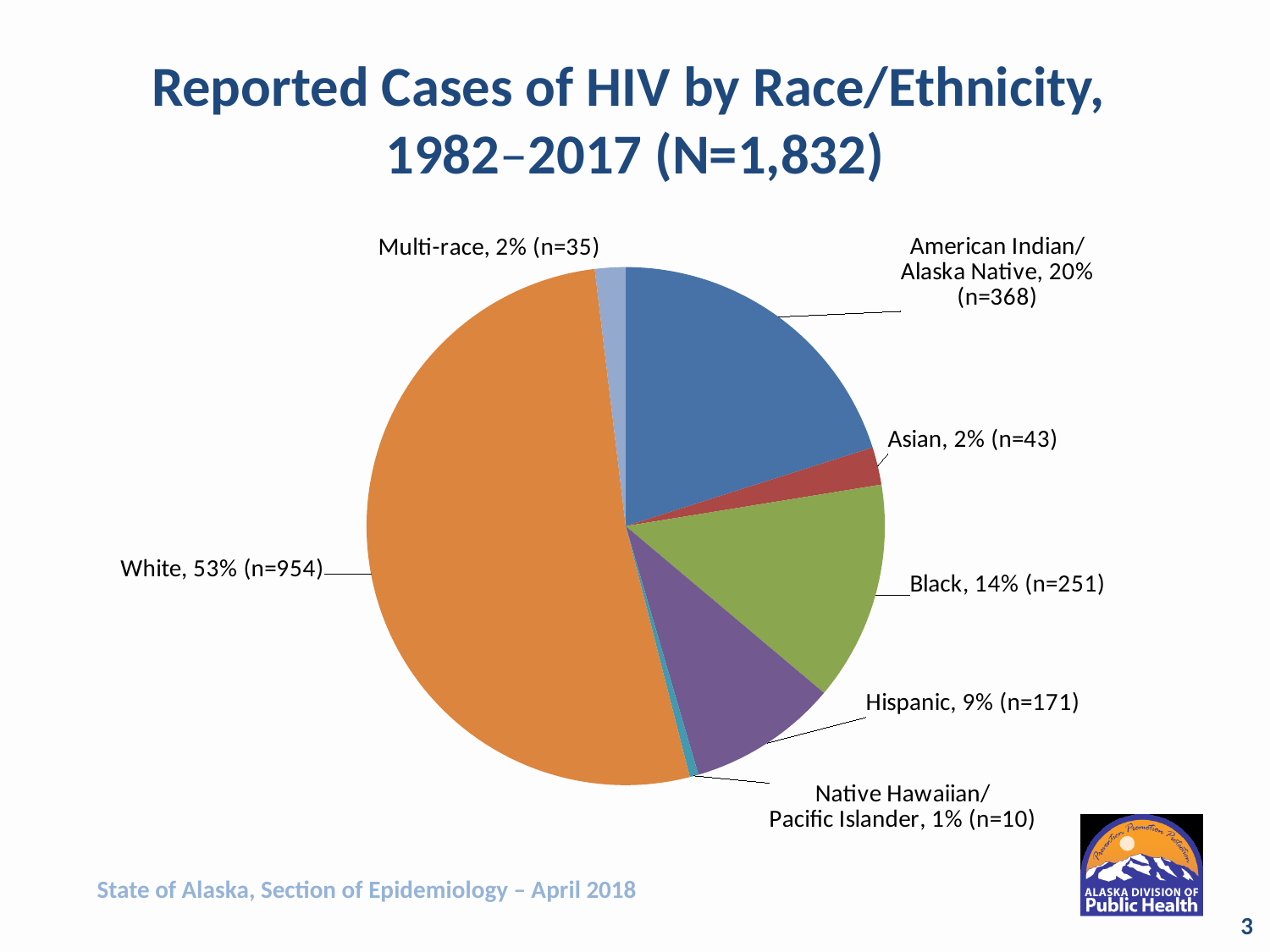
What is the total number of reported HIV cases (N) stated in the chart title? 1,832 What share of the pie does the Hispanic slice represent? 9% How many race/ethnicity categories are shown in the pie chart? 7 What is the difference in number of cases between American Indian/Alaska Native (n=368) and Black (n=251)? 117 Which race/ethnicity category has the largest share of reported HIV cases? White What percentage of reported HIV cases were among White individuals? 53% Which race/ethnicity category has the smallest share of reported HIV cases? Native Hawaiian/Pacific Islander How many reported HIV cases (n) were among Black individuals? 251 Which category has more reported cases, Asian or Multi-race? Asian What percentage of reported HIV cases were among American Indian/Alaska Native individuals? 20% What time period does the chart title cover? 1982–2017 What type of chart is shown on the slide? Pie chart